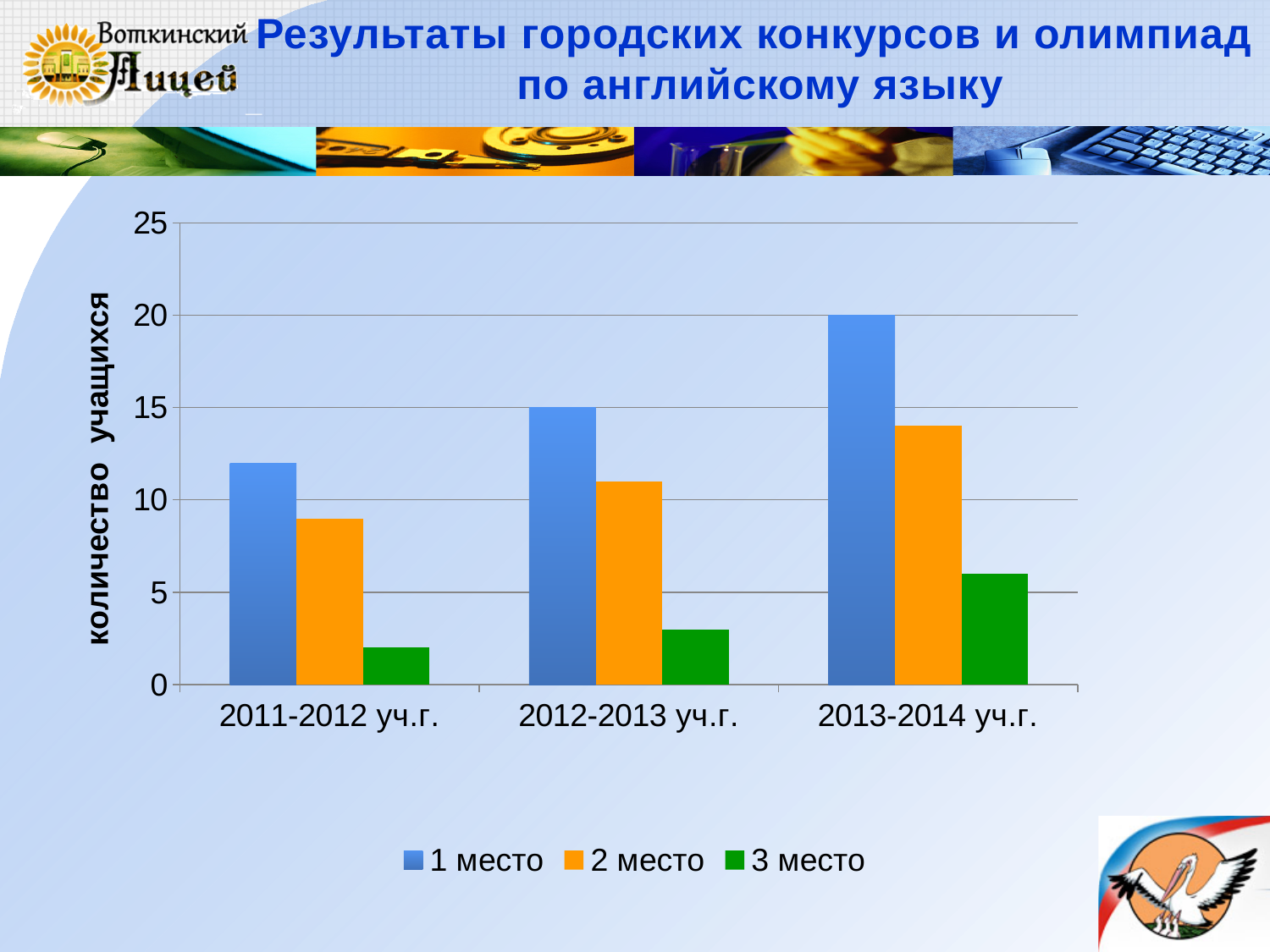
Is the value for 3 место in 2012-2013 уч.г. greater or less than 5? less Is the value for 2 место in 2011-2012 уч.г. greater or less than 10? less Which is larger: 1 место in 2011-2012 уч.г. or 2 место in 2013-2014 уч.г.? 2 место in 2013-2014 уч.г. What kind of chart is shown on the slide? bar chart Which academic year has the highest value for 1 место? 2013-2014 уч.г. What is the value for 1 место in 2013-2014 уч.г.? 20 What is the value for 1 место in 2012-2013 уч.г.? 15 How many academic years are shown on the x axis? 3 Is the value for 2 место in 2013-2014 уч.г. greater or less than 10? greater Do the values for 1 место rise or fall from 2011-2012 уч.г. to 2013-2014 уч.г.? rise How many series does the legend list? 3 Which academic year has the lowest value for 3 место? 2011-2012 уч.г.